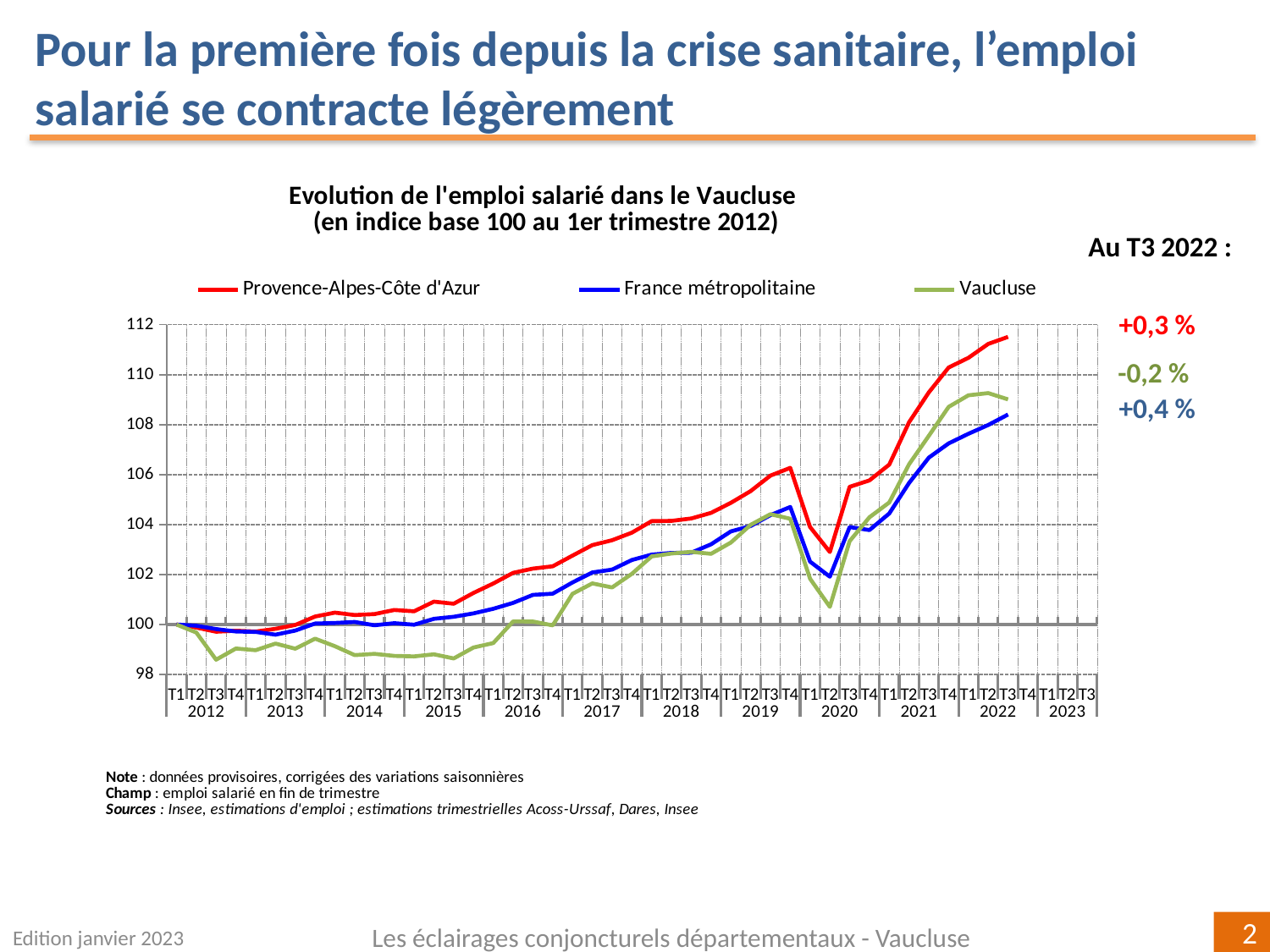
Is the value for Provence-Alpes-Côte d'Azur at T3 2022 greater or less than 110? greater Is the value for Vaucluse at T2 2020 greater or less than 102? less How many series does the legend list? 3 Overall, do the values for France métropolitaine rise or fall between 2012 and 2022? rise Is the value for France métropolitaine at T3 2022 greater or less than 110? less Which series are listed in the legend? Provence-Alpes-Côte d'Azur, France métropolitaine, Vaucluse Which series has the highest value at T3 2022? Provence-Alpes-Côte d'Azur Which series has the lowest value at T3 2022? France métropolitaine According to the annotation at the right of the chart, what is the change for Vaucluse at T3 2022? -0,2 % What kind of chart is shown on the slide? line chart At T3 2022, which is higher: Provence-Alpes-Côte d'Azur or Vaucluse? Provence-Alpes-Côte d'Azur